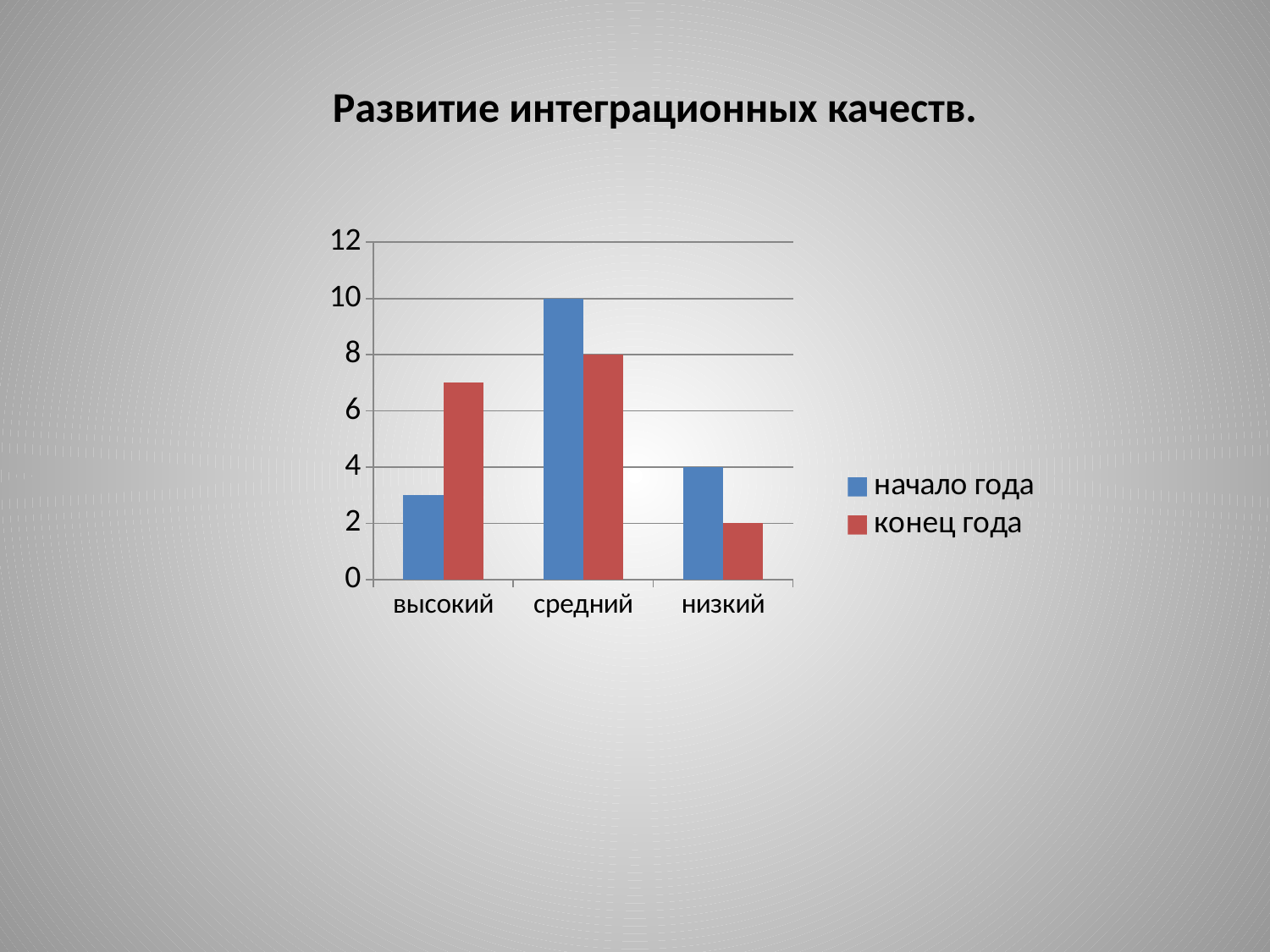
Is the value for высокий in the конец года series greater or less than 6? greater How many series does the legend list? 2 What is the value for низкий in the начало года series? 4 How many categories are shown on the x axis? 3 What is the value for средний in the конец года series? 8 What is the difference between the начало года and конец года values for средний? 2 What kind of chart is shown on the slide? bar chart Which category has the highest value in the начало года series? средний What is the value for средний in the начало года series? 10 Is the value for высокий in the начало года series greater or less than 4? less What is the title of the slide? Развитие интеграционных качеств. What is the value for низкий in the конец года series? 2